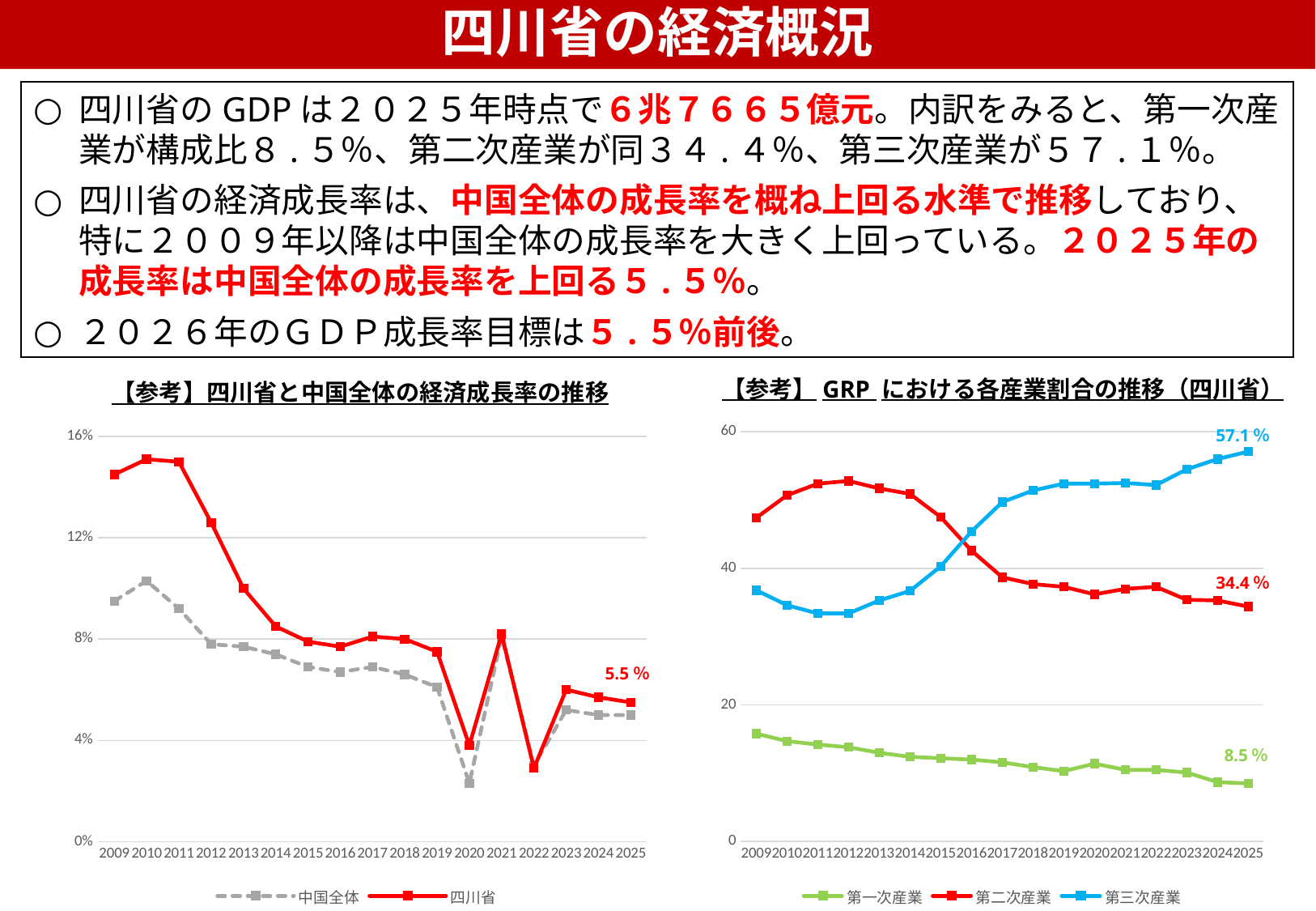
In the right chart (GRP における各産業割合の推移（四川省）), what is the difference between 第三次産業 and 第二次産業 in 2025? 22.7％ In the right chart (GRP における各産業割合の推移（四川省）), which series has the highest value in 2025? 第三次産業 In the left chart (四川省と中国全体の経済成長率の推移), is the value for 四川省 in 2009 greater or less than 12%? greater In the left chart (四川省と中国全体の経済成長率の推移), how many series does the legend list? 2 In the left chart (四川省と中国全体の経済成長率の推移), which is larger in 2011, 四川省 or 中国全体? 四川省 In the left chart (四川省と中国全体の経済成長率の推移), how many years are shown on the x axis? 17 In the left chart (四川省と中国全体の経済成長率の推移), does the 四川省 line overall rise or fall from 2009 to 2025? fall What kind of chart is the left chart titled 【参考】四川省と中国全体の経済成長率の推移? line chart In the right chart (GRP における各産業割合の推移（四川省）), what is the value for 第三次産業 in 2025? 57.1％ In the right chart (GRP における各産業割合の推移（四川省）), what is the value for 第一次産業 in 2025? 8.5％ In the right chart (GRP における各産業割合の推移（四川省）), how many series does the legend list? 3 In the left chart (四川省と中国全体の経済成長率の推移), what is the value for 四川省 in 2025? 5.5％